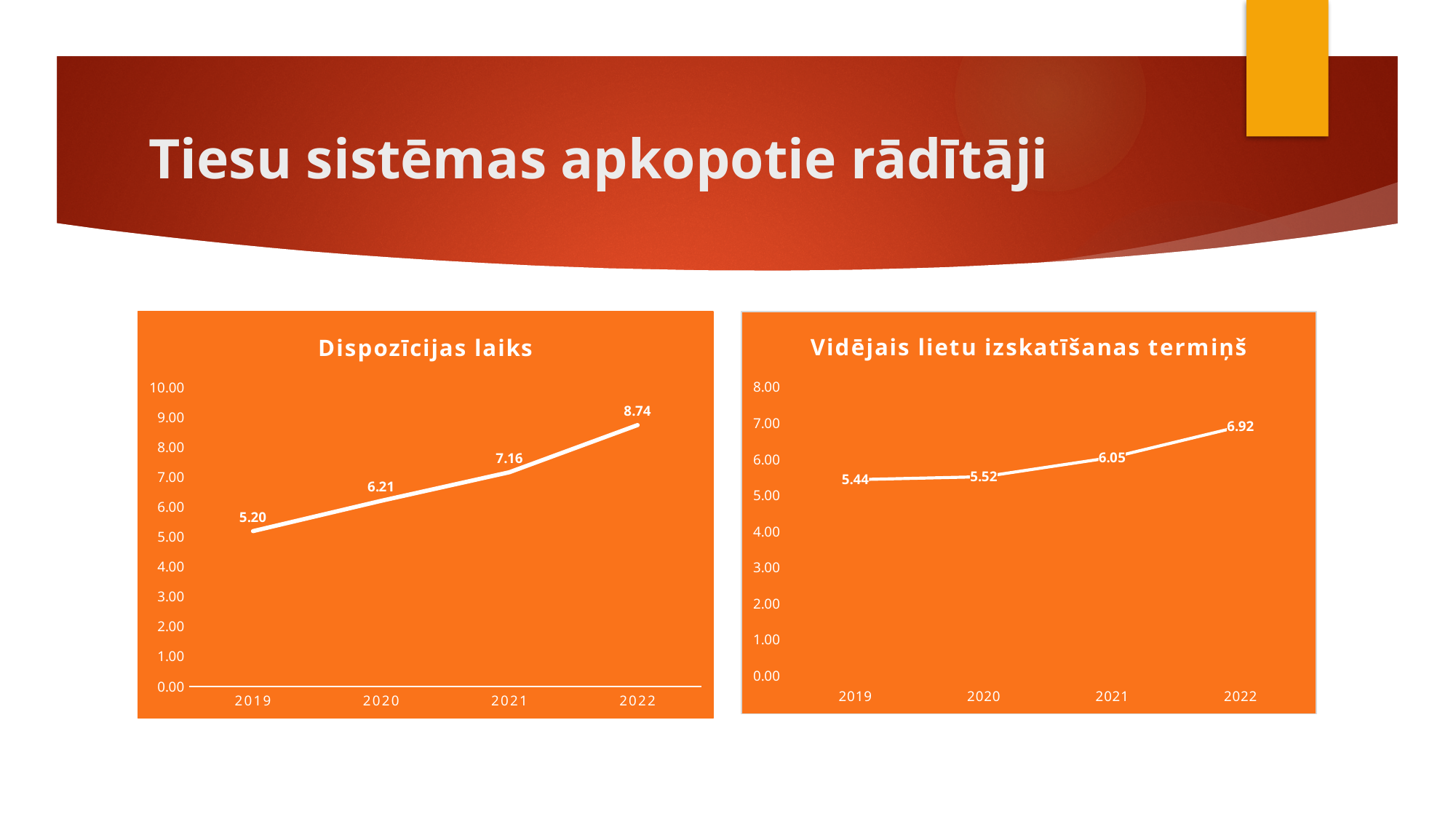
In the 'Vidējais lietu izskatīšanas termiņš' chart, what is the value for 2022? 6.92 Which is larger: the 2021 value in 'Dispozīcijas laiks' or the 2021 value in 'Vidējais lietu izskatīšanas termiņš'? Dispozīcijas laiks (7.16) What kind of chart is 'Dispozīcijas laiks'? line chart In the 'Dispozīcijas laiks' chart, which year has the highest value? 2022 In the 'Vidējais lietu izskatīšanas termiņš' chart, what is the value for 2020? 5.52 In the 'Dispozīcijas laiks' chart, do the values rise or fall from 2019 to 2022? rise In the 'Vidējais lietu izskatīšanas termiņš' chart, how many years are plotted? 4 In the 'Vidējais lietu izskatīšanas termiņš' chart, what is the difference between the 2021 and 2020 values? 0.53 In the 'Dispozīcijas laiks' chart, what is the value for 2021? 7.16 In the 'Dispozīcijas laiks' chart, what is the difference between the 2022 and 2019 values? 3.54 In the 'Dispozīcijas laiks' chart, which year has the lowest value? 2019 What is the title of the chart on the right side of the slide? Vidējais lietu izskatīšanas termiņš